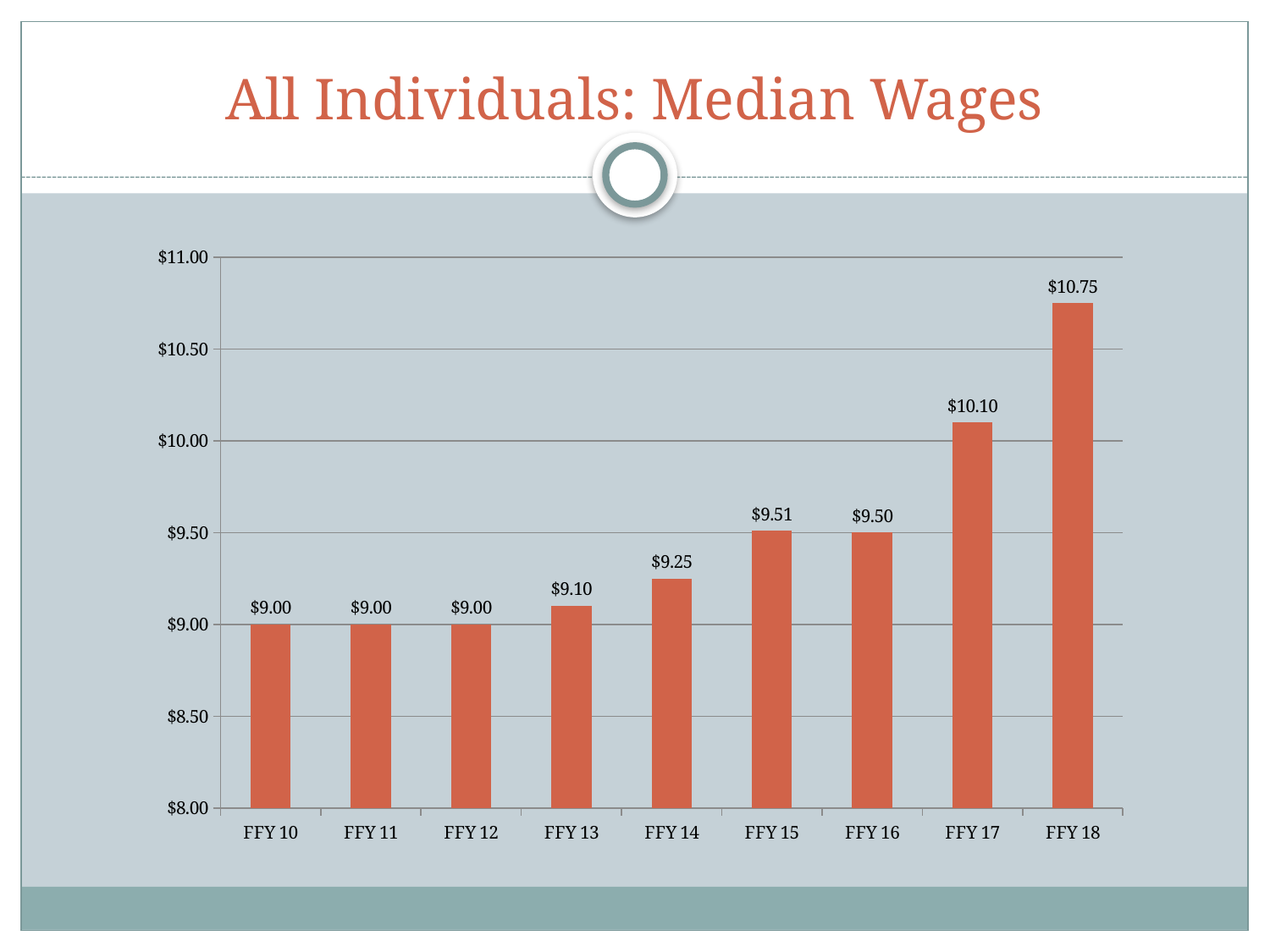
What is the difference between the median wage in FFY 13 and FFY 12? $0.10 Which fiscal year has the highest median wage? FFY 18 What is the difference between the median wage in FFY 18 and FFY 17? $0.65 How many fiscal years are shown on the chart? 9 What kind of chart is shown on the slide? Bar chart What is the lowest median wage shown on the chart? $9.00 Which is larger, the median wage in FFY 15 or FFY 16? FFY 15 What is the median wage for FFY 18? $10.75 What is the median wage for FFY 14? $9.25 What is the median wage for FFY 17? $10.10 Is the median wage for FFY 17 greater or less than $10.00? greater Do median wages generally rise or fall from FFY 10 to FFY 18? Rise